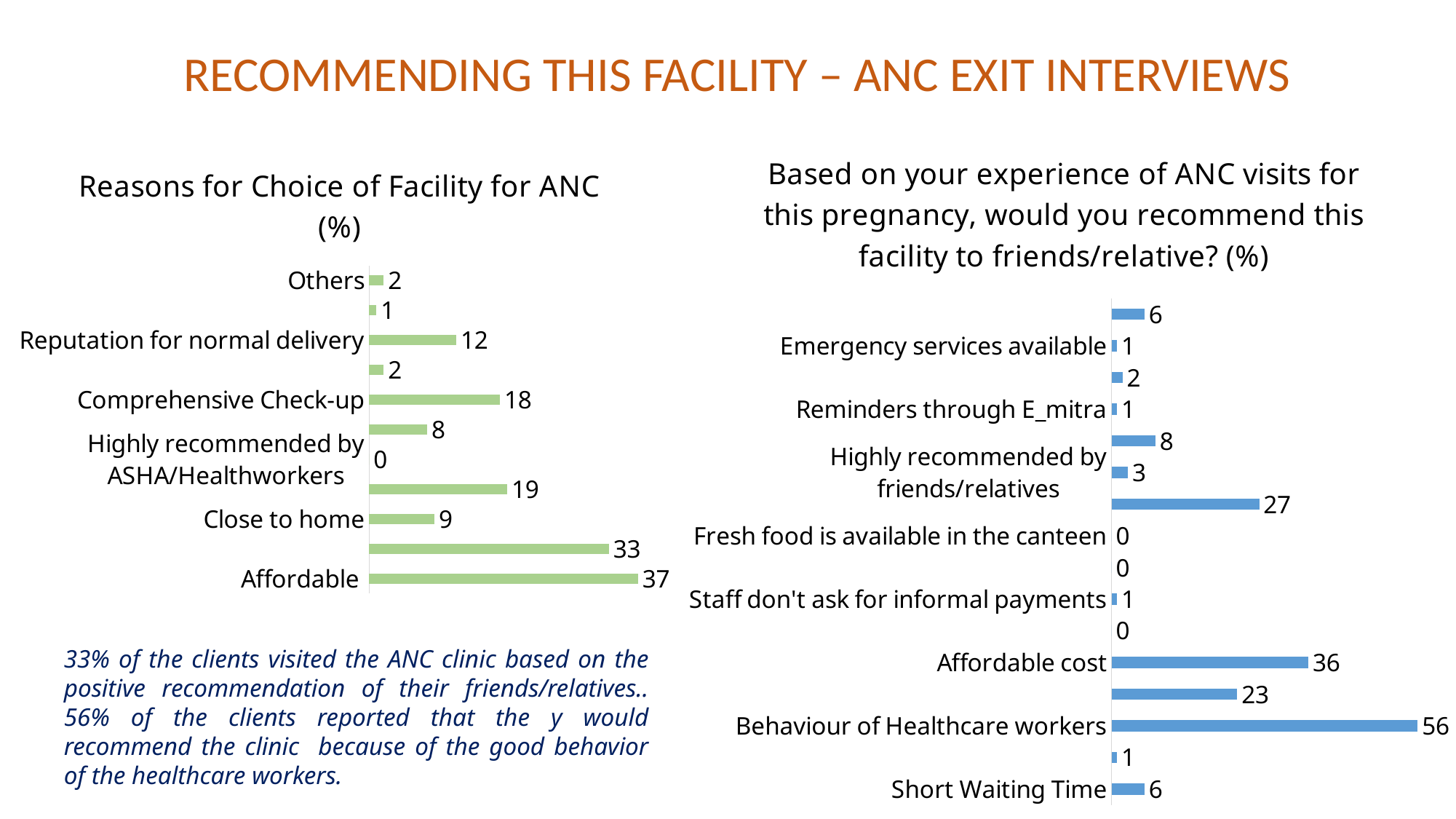
In the chart on the right about recommending the facility to friends/relatives, what is the value for Affordable cost? 36 In the 'Reasons for Choice of Facility for ANC (%)' chart, what is the value for Affordable? 37 In the chart on the right about recommending the facility to friends/relatives, what is the value for Short Waiting Time? 6 In the 'Reasons for Choice of Facility for ANC (%)' chart, what is the value for Comprehensive Check-up? 18 In the 'Reasons for Choice of Facility for ANC (%)' chart, what is the difference between Affordable and Comprehensive Check-up? 19 In the 'Reasons for Choice of Facility for ANC (%)' chart, which labelled category has the highest value? Affordable In the 'Reasons for Choice of Facility for ANC (%)' chart, what is the value for Reputation for normal delivery? 12 In the chart on the right about recommending the facility to friends/relatives, what is the difference between Behaviour of Healthcare workers and Affordable cost? 20 In the chart on the right about recommending the facility to friends/relatives, what is the value for Behaviour of Healthcare workers? 56 In the 'Reasons for Choice of Facility for ANC (%)' chart, which is larger: Close to home or Comprehensive Check-up? Comprehensive Check-up What type of chart is the 'Reasons for Choice of Facility for ANC (%)' chart? Bar chart In the chart on the right about recommending the facility to friends/relatives, which category has the highest value? Behaviour of Healthcare workers